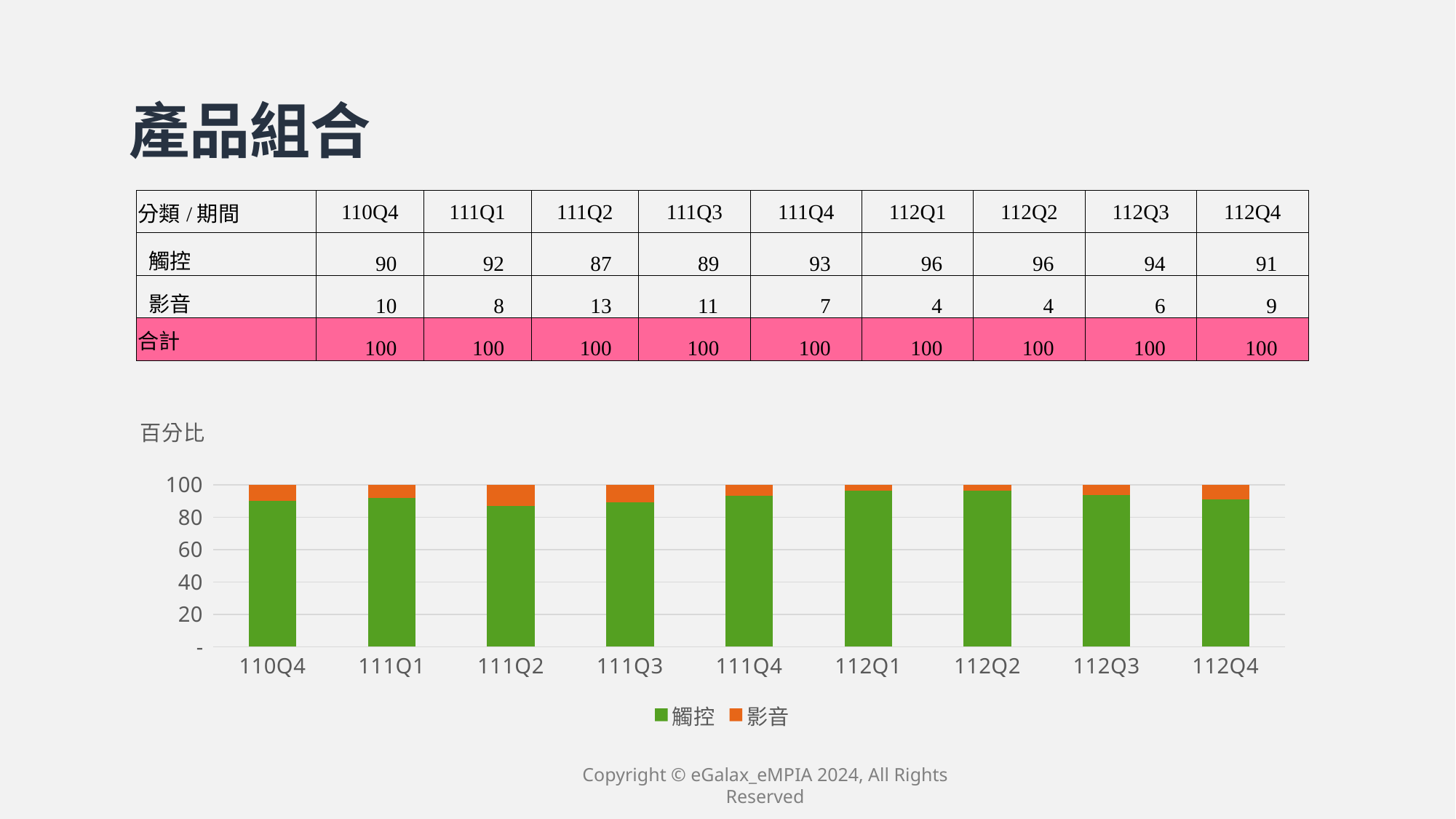
How many series does the chart legend list? 2 What is the value of 觸控 for 111Q2? 87 What is the value of 影音 for 112Q4? 9 What kind of chart is shown on the slide? stacked bar chart Which colour represents 影音 in the chart? orange What is the total of the stacked bar for 112Q1? 100 Is the value of 觸控 for 112Q2 greater or less than 80? greater Which is larger, 影音 in 111Q3 or 影音 in 111Q4? 111Q3 How many quarters are shown on the x axis of the chart? 9 In which quarter is 影音 highest? 111Q2 In which quarter is 觸控 lowest? 111Q2 What is the difference between 觸控 and 影音 in 110Q4? 80